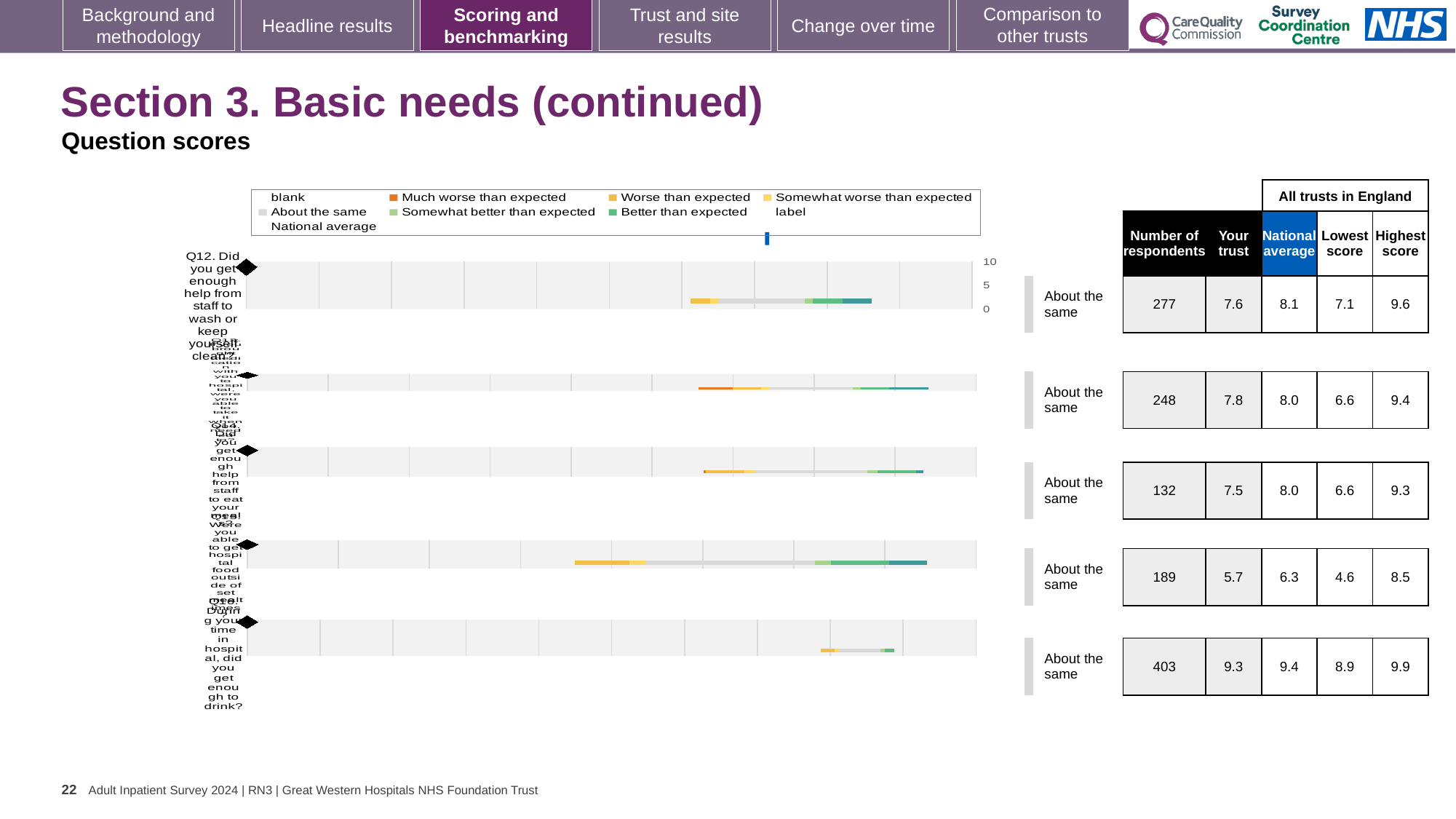
How many respondents are listed in the table for the first chart (Q12, help from staff to wash or keep yourself clean)? 277 What is the highest tick value shown on the axis of the first bar chart? 10 How many question-score bar charts are shown on the slide? 5 Which legend entry is shown in orange? Much worse than expected What kind of chart is used for the question scores on this slide? bar chart What is the national average printed in the table for the first chart (Q12, help from staff to wash or keep yourself clean)? 8.1 What benchmark category is printed beside every one of the five charts? About the same What is the 'Your trust' score printed in the table for the first chart (Q12, help from staff to wash or keep yourself clean)? 7.6 For the first chart (Q12), what is the difference between the highest score (9.6) and the lowest score (7.1) in the table? 2.5 For the first chart (Q12), which is larger: the 'Your trust' score or the national average? National average Which legend entry is shown in grey? About the same